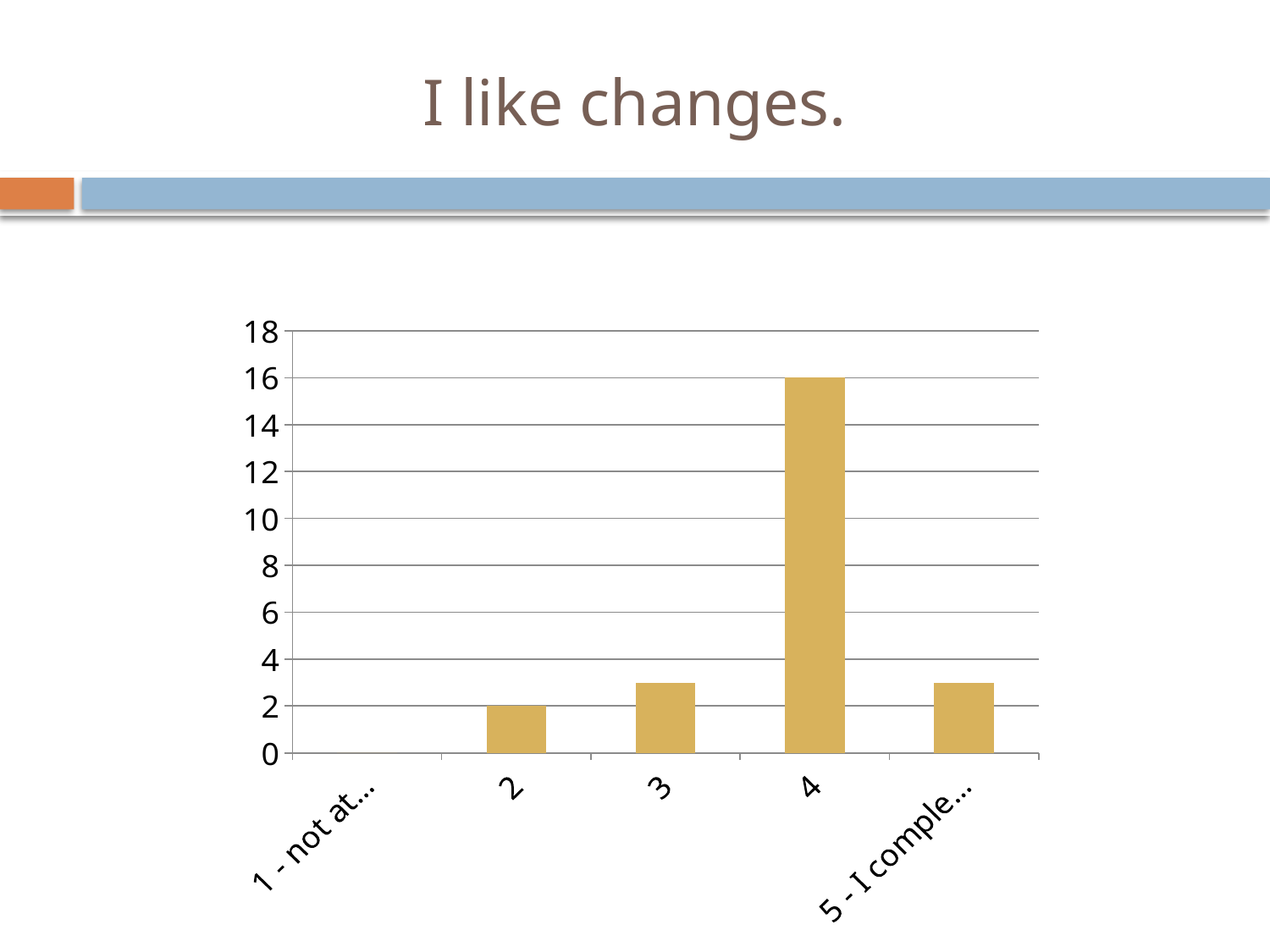
Which has the larger value, category 4 or category 2? 4 What is the value for category 2? 2 What is the title of the slide? I like changes. What kind of chart is shown on the slide? bar chart Which category has the highest value? 4 Is the value for category 3 greater or less than 2? greater Is the value for category 4 greater or less than 10? greater What is the highest value shown on the y axis? 18 How many categories are shown on the x axis? 5 What is the difference between the values for category 4 and category 2? 14 Is the value for category 3 greater or less than 4? less What is the value for category 4? 16